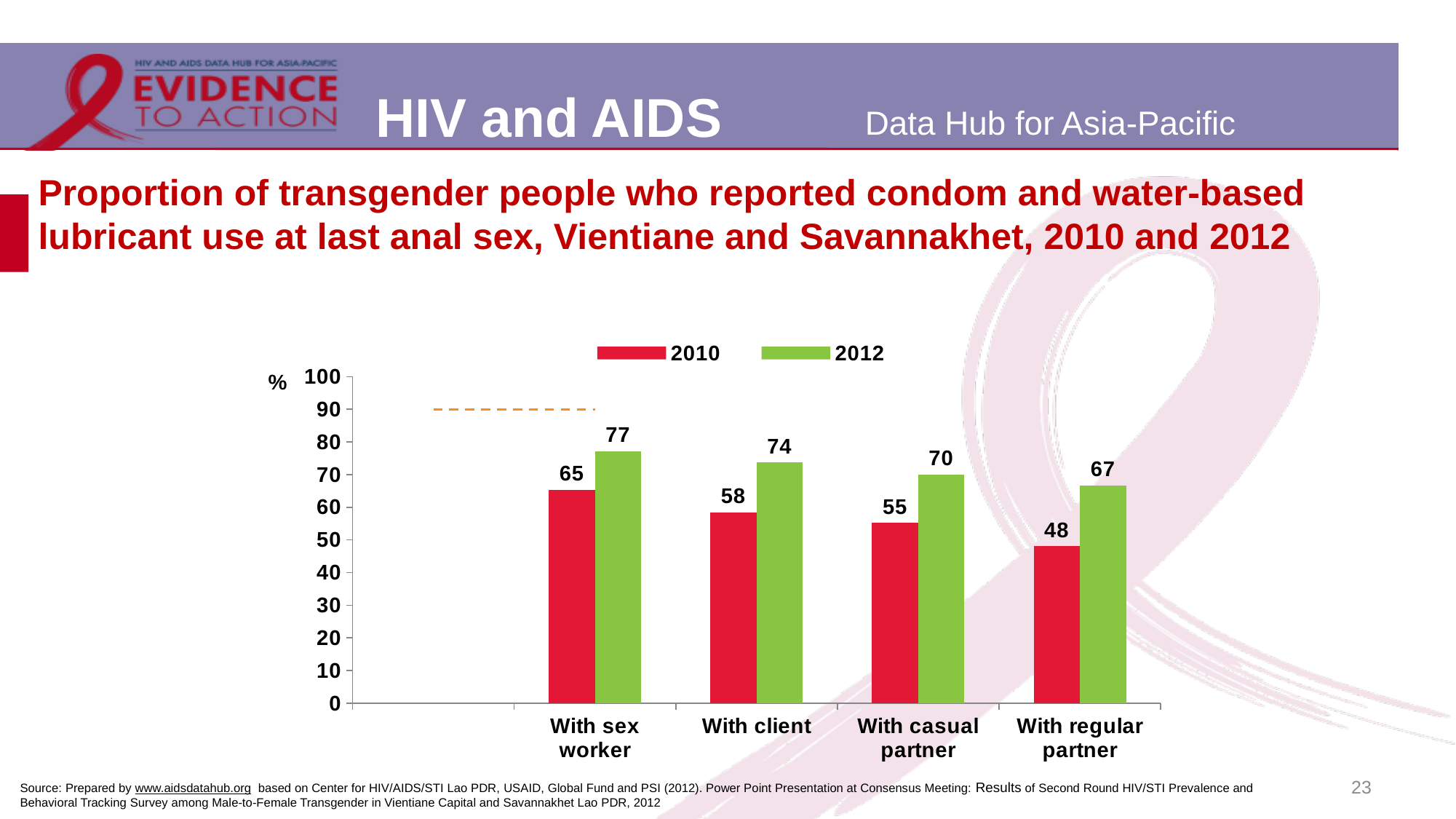
Which colour represents the 2012 series in the legend? Green Which category has the highest 2012 value? With sex worker What is the difference between the 2012 and 2010 values for 'With casual partner'? 15 What is the 2010 value for 'With sex worker'? 65 How many series does the legend list? 2 What is the difference between the 2012 and 2010 values for 'With regular partner'? 19 What is the 2012 value for 'With regular partner'? 67 Which category has the lowest 2010 value? With regular partner Which is larger: the 2010 value for 'With client' or the 2010 value for 'With casual partner'? With client What is the 2012 value for 'With client'? 74 How many categories are shown on the x axis? 4 What kind of chart is shown on the slide? Bar chart